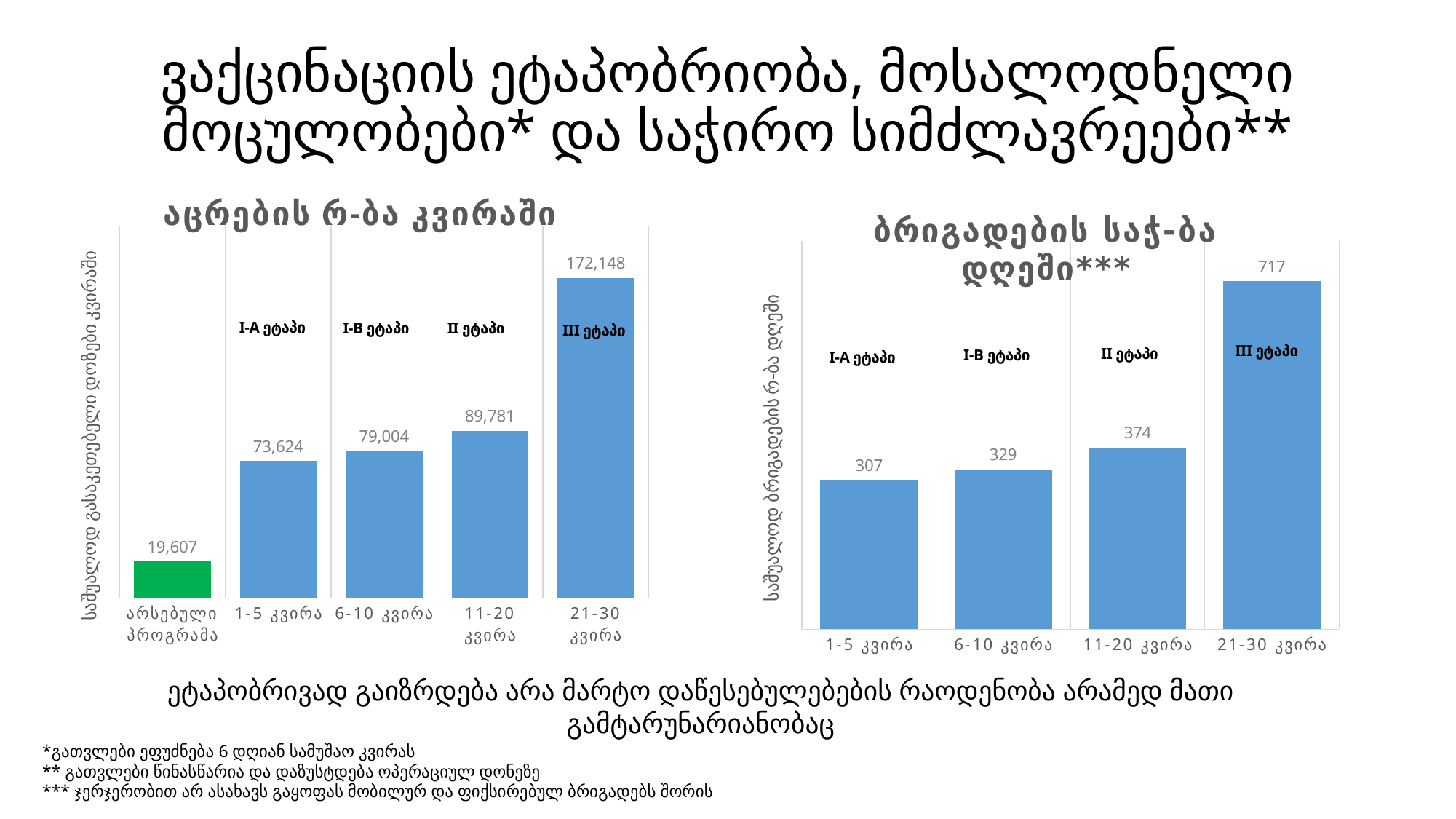
What type of chart is the right chart (ბრიგადების საჭ-ბა დღეში)? bar chart In the left chart (აცრების რ-ბა კვირაში), what is the value for არსებული პროგრამა? 19,607 In the left chart (აცრების რ-ბა კვირაში), which bar is coloured green rather than blue? არსებული პროგრამა In the left chart (აცრების რ-ბა კვირაში), how many bars are plotted? 5 In the right chart (ბრიგადების საჭ-ბა დღეში), which is larger: the value for 1-5 კვირა or 6-10 კვირა? 6-10 კვირა In the right chart (ბრიგადების საჭ-ბა დღეში), what is the difference between the values for 21-30 კვირა and 11-20 კვირა? 343 In the left chart (აცრების რ-ბა კვირაში), what is the value for 21-30 კვირა? 172,148 In the left chart (აცრების რ-ბა კვირაში), which category has the lowest value? არსებული პროგრამა In the left chart (აცრების რ-ბა კვირაში), do the values rise or fall from left to right across the categories? rise In the left chart (აცრების რ-ბა კვირაში), what is the difference between the values for 6-10 კვირა and 1-5 კვირა? 5,380 In the right chart (ბრიგადების საჭ-ბა დღეში), which category has the highest value? 21-30 კვირა In the right chart (ბრიგადების საჭ-ბა დღეში), what is the value for 11-20 კვირა? 374